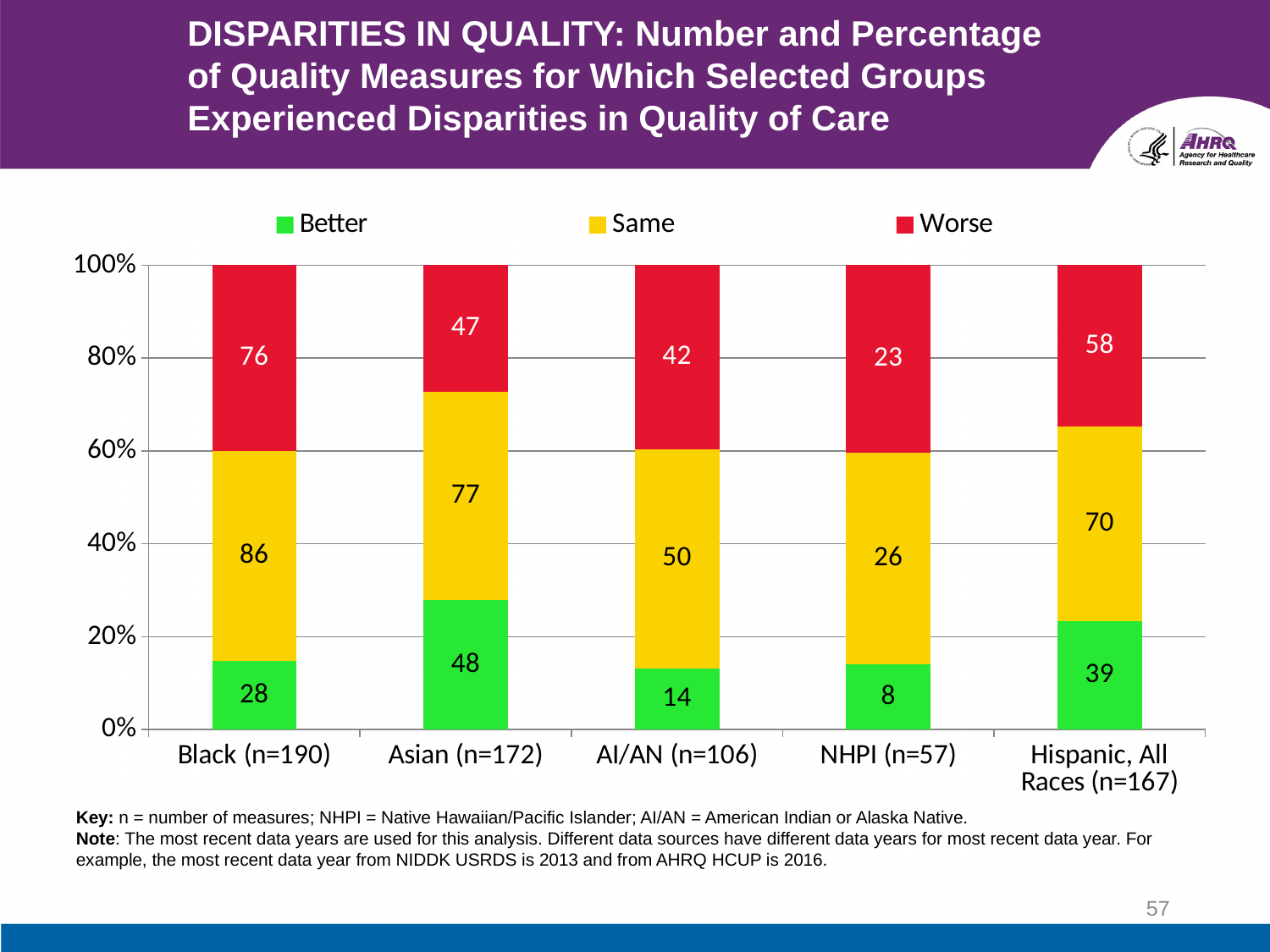
What is the Better value for NHPI (n=57)? 8 What is the Same value for Asian (n=172)? 77 Which group has the lowest Worse value? NHPI (n=57) Which group has the highest Better value? Asian (n=172) What is the difference between the Same value for Black (n=190) and the Same value for AI/AN (n=106)? 36 Which is larger: the Worse value for Asian (n=172) or the Worse value for AI/AN (n=106)? Asian (n=172) How many groups are shown on the x axis? 5 What kind of chart is shown on the slide? Stacked bar chart What is the Worse value for Hispanic, All Races (n=167)? 58 What is the total of the Better, Same and Worse values for AI/AN (n=106)? 106 How many series does the legend list? 3 What is the number of quality measures for which Black (n=190) experienced Worse quality of care? 76